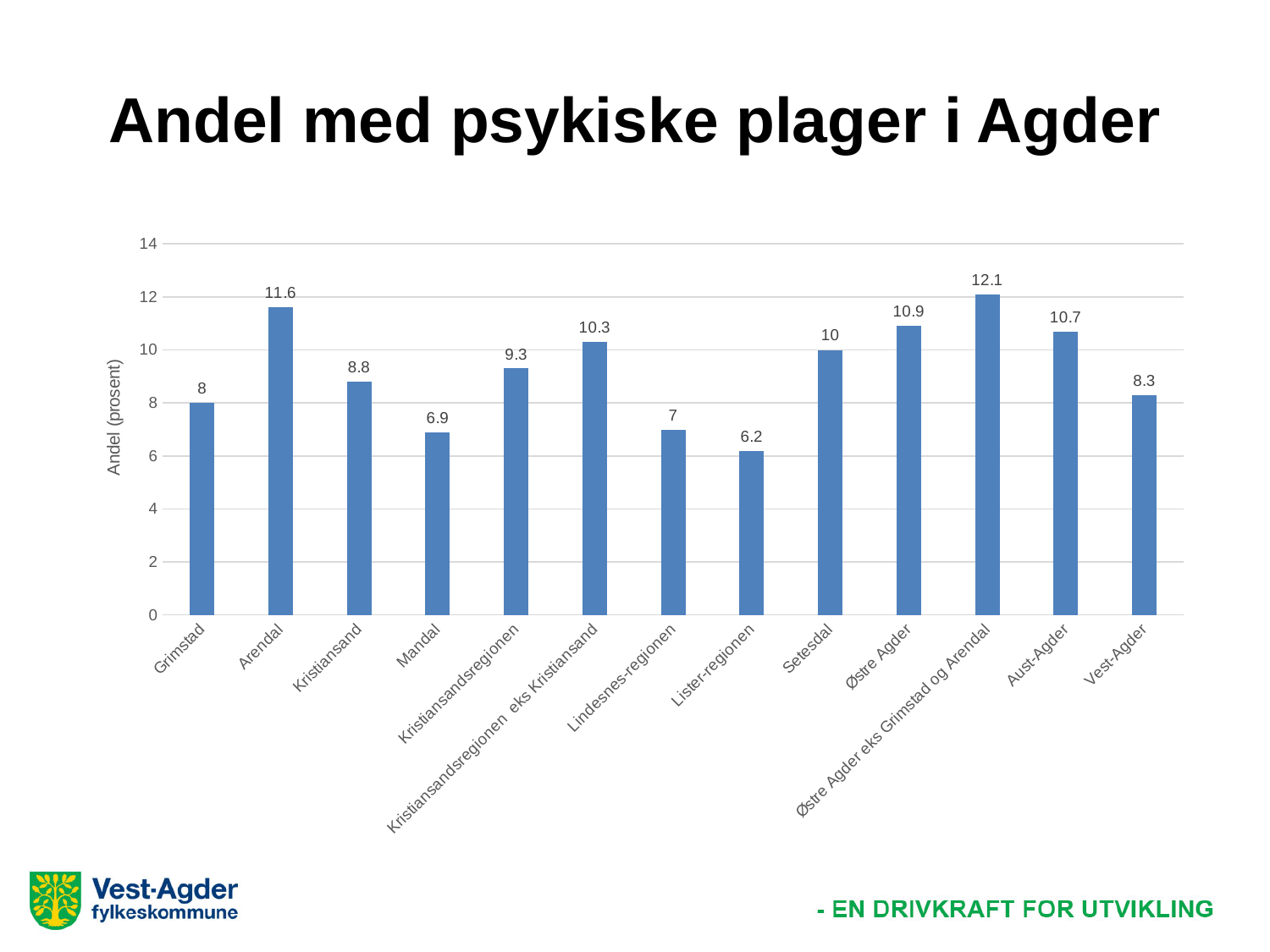
What is the value for Kristiansandsregionen eks Kristiansand? 10.3 What is the difference between the values for Aust-Agder and Vest-Agder? 2.4 What is the value for Arendal? 11.6 How many categories are shown on the x axis? 13 Which category has the lowest value? Lister-regionen What kind of chart is shown on the slide? bar chart What is the value for Lister-regionen? 6.2 Which category has the highest value? Østre Agder eks Grimstad og Arendal Which is larger, the value for Kristiansand or the value for Mandal? Kristiansand What is the label of the y axis? Andel (prosent) What is the title of the chart? Andel med psykiske plager i Agder Is the value for Setesdal greater or less than 8? greater